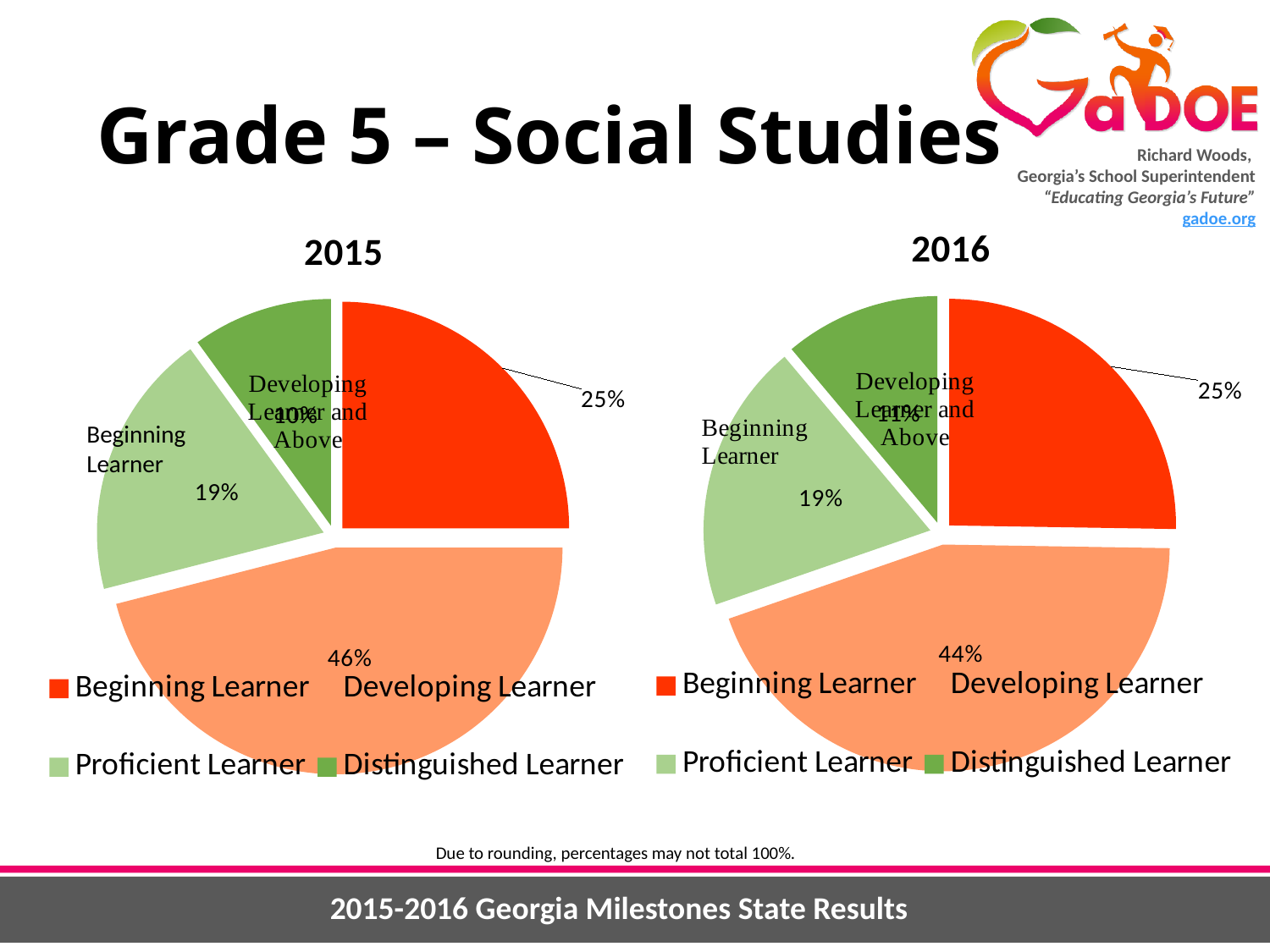
In the 2015 chart, which category has the smallest slice? Distinguished Learner What is the difference between the Developing Learner percentage in the 2015 chart and in the 2016 chart? 2% What type of chart is the 2015 chart? Pie chart In the 2016 chart, which colour represents Beginning Learner? Red In the 2016 chart, what percentage is shown for Distinguished Learner? 11% How many categories does the legend of the 2016 chart list? 4 In the 2015 chart, which category has the largest slice? Developing Learner In the 2016 chart, what percentage is shown for Developing Learner? 44% In the 2016 chart, what percentage is shown for Proficient Learner? 19% In the 2015 chart, what percentage is shown for Beginning Learner? 25% Is the Distinguished Learner slice larger in the 2015 chart or the 2016 chart? 2016 In the 2015 chart, what percentage is shown for Developing Learner? 46%